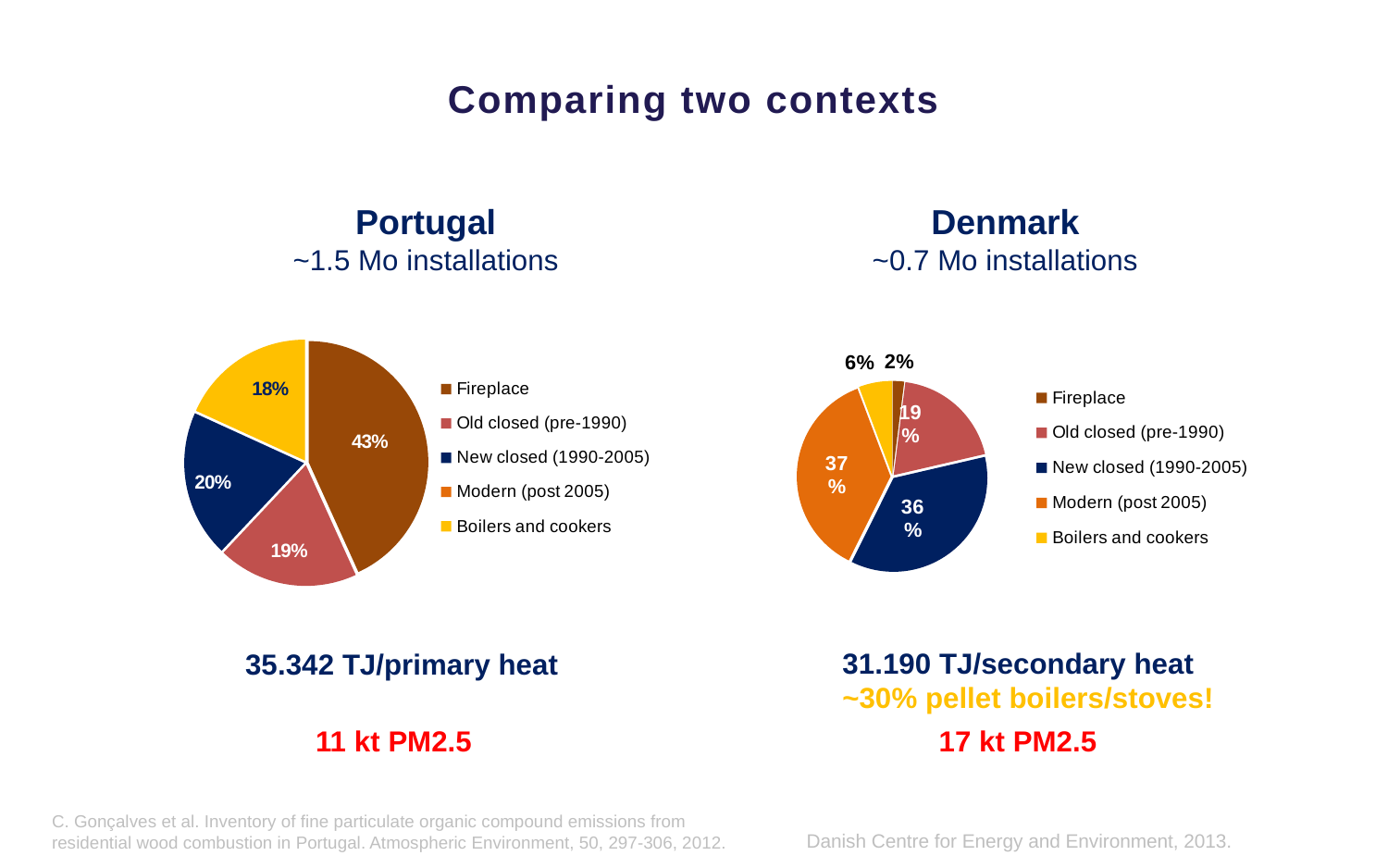
In the Portugal pie chart, what share is Boilers and cookers? 18% In the Denmark pie chart, what share is Modern (post 2005)? 37% In the Portugal pie chart, what share is Old closed (pre-1990)? 19% In the Portugal pie chart, what is the combined share of New closed (1990-2005) and Old closed (pre-1990)? 39% What type of chart is used for Portugal and Denmark? Pie chart In the Portugal pie chart, what share is Fireplace? 43% In the Portugal pie chart, which category has the largest share? Fireplace In the Denmark pie chart, which category has the smallest share? Fireplace Which is larger: the Fireplace share in the Portugal chart or the Fireplace share in the Denmark chart? Portugal In the Denmark pie chart, what is the difference between the Old closed (pre-1990) share and the Boilers and cookers share? 13% How many entries does the legend of the Denmark pie chart list? 5 In the Denmark pie chart, what share is New closed (1990-2005)? 36%